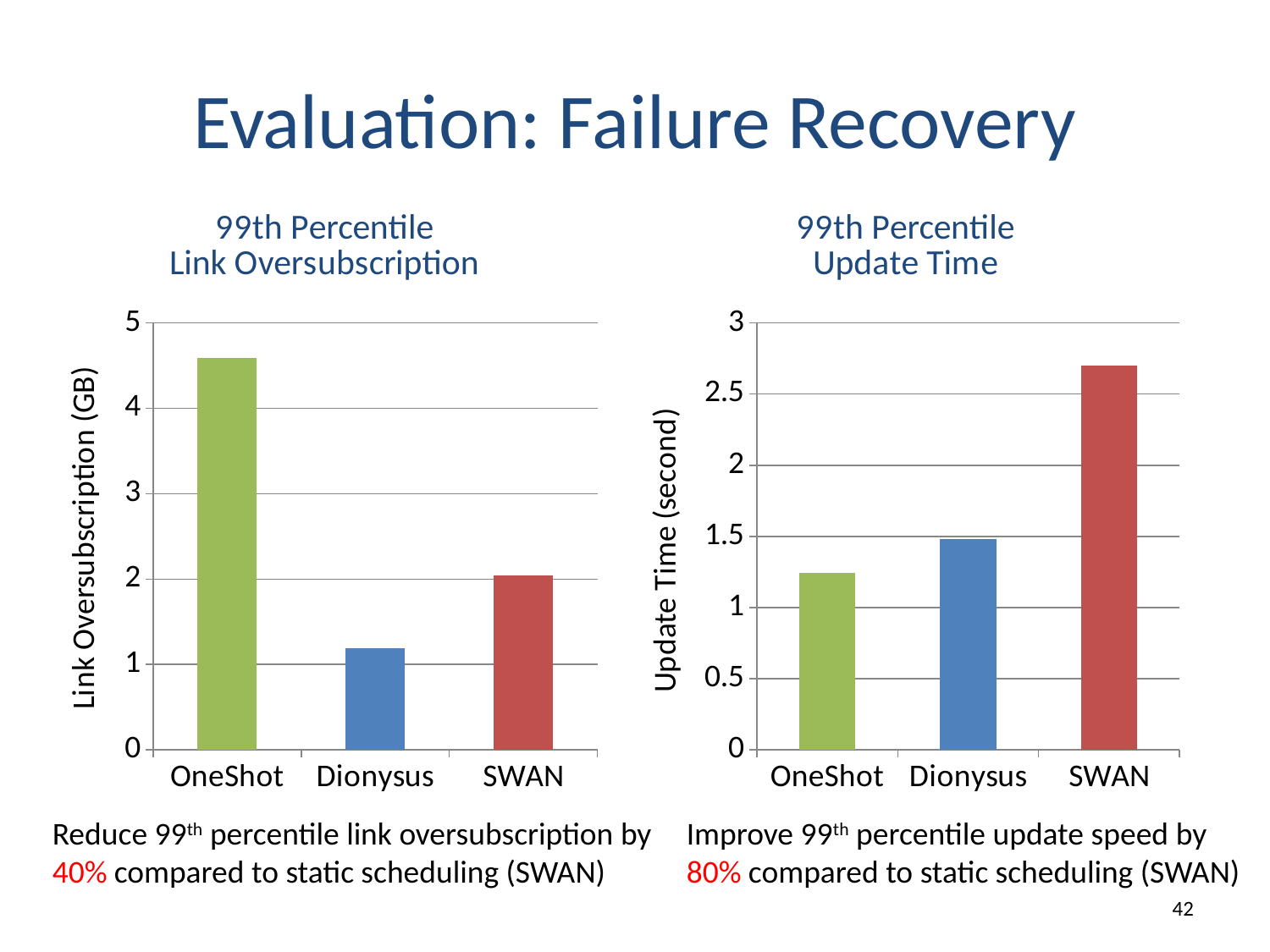
In the 99th Percentile Update Time chart, which category has the highest value? SWAN How many categories are shown in the 99th Percentile Update Time chart? 3 In the 99th Percentile Link Oversubscription chart, which category has the highest value? OneShot In the 99th Percentile Link Oversubscription chart, which category has the lowest value? Dionysus What type of chart is the 99th Percentile Link Oversubscription chart? Bar chart In the 99th Percentile Update Time chart, is the value for SWAN greater or less than 2.5? greater In the 99th Percentile Link Oversubscription chart, which is larger, SWAN or Dionysus? SWAN In the 99th Percentile Update Time chart, which is larger, Dionysus or OneShot? Dionysus In the 99th Percentile Link Oversubscription chart, is the value for Dionysus greater or less than 2? less In the 99th Percentile Update Time chart, is the value for OneShot greater or less than 1? greater In the 99th Percentile Update Time chart, which category has the lowest value? OneShot